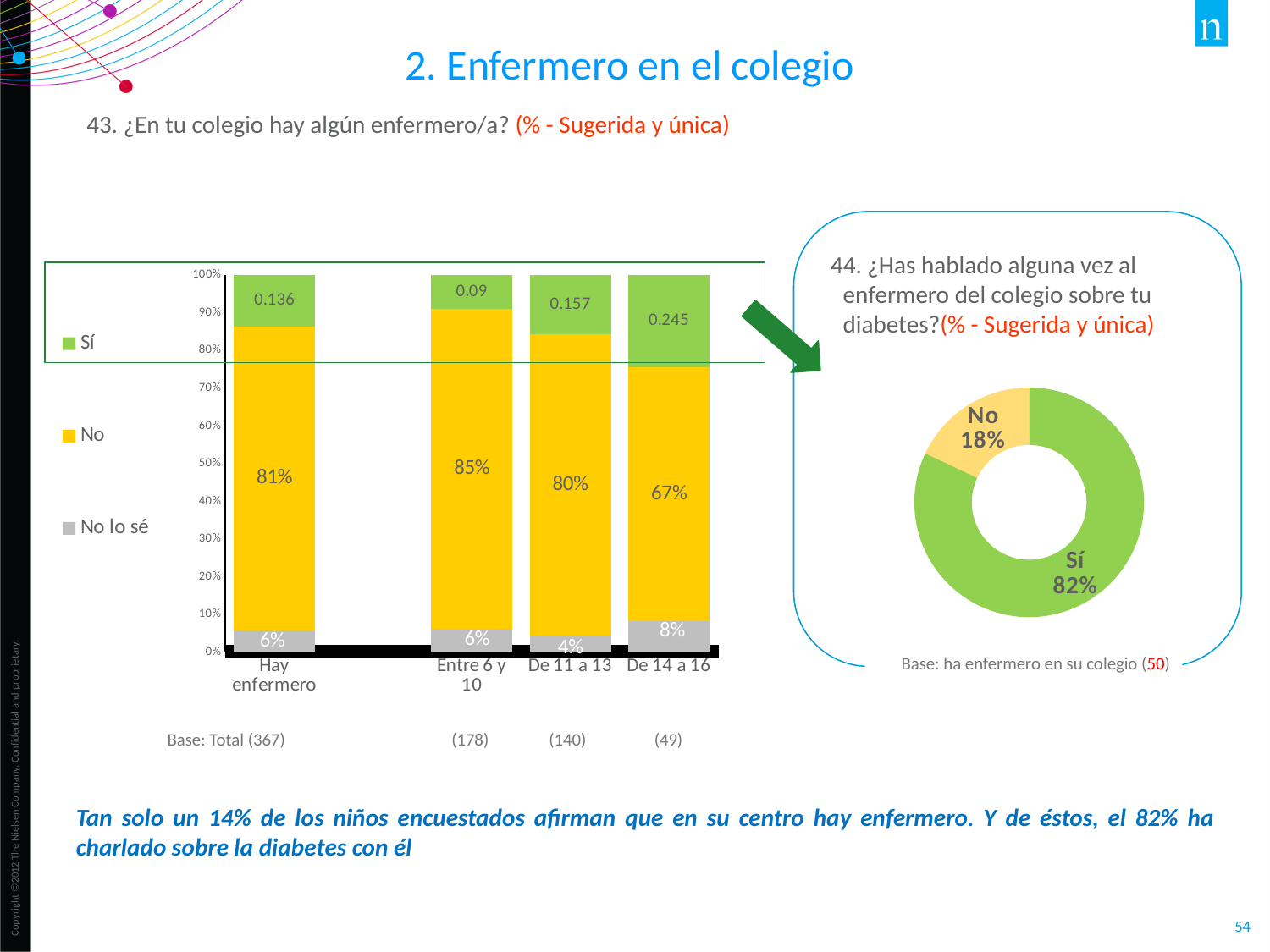
What kind of chart is used for question 44 on the right of the slide? Donut chart In the stacked bar chart for question 43, is the 'Sí' value larger for 'De 11 a 13' or for 'Entre 6 y 10'? De 11 a 13 In the stacked bar chart for question 43, what is the 'No' value for the 'Entre 6 y 10' category? 85% In the donut chart for question 44, what is the value for 'No'? 18% How many series does the legend of the stacked bar chart for question 43 list? 3 In the stacked bar chart for question 43, what is the 'Sí' value shown for the 'De 14 a 16' category? 0.245 In the stacked bar chart for question 43, which category has the lowest 'No' value? De 14 a 16 In the stacked bar chart for question 43, what is the difference between the 'No' values for 'Hay enfermero' and 'De 14 a 16'? 14% How many categories are shown on the x axis of the stacked bar chart for question 43? 4 In the stacked bar chart for question 43, which category has the highest 'No' value? Entre 6 y 10 In the stacked bar chart for question 43, what is the 'No lo sé' value for the 'De 11 a 13' category? 4% In the donut chart for question 44, what share of respondents answered 'Sí'? 82%